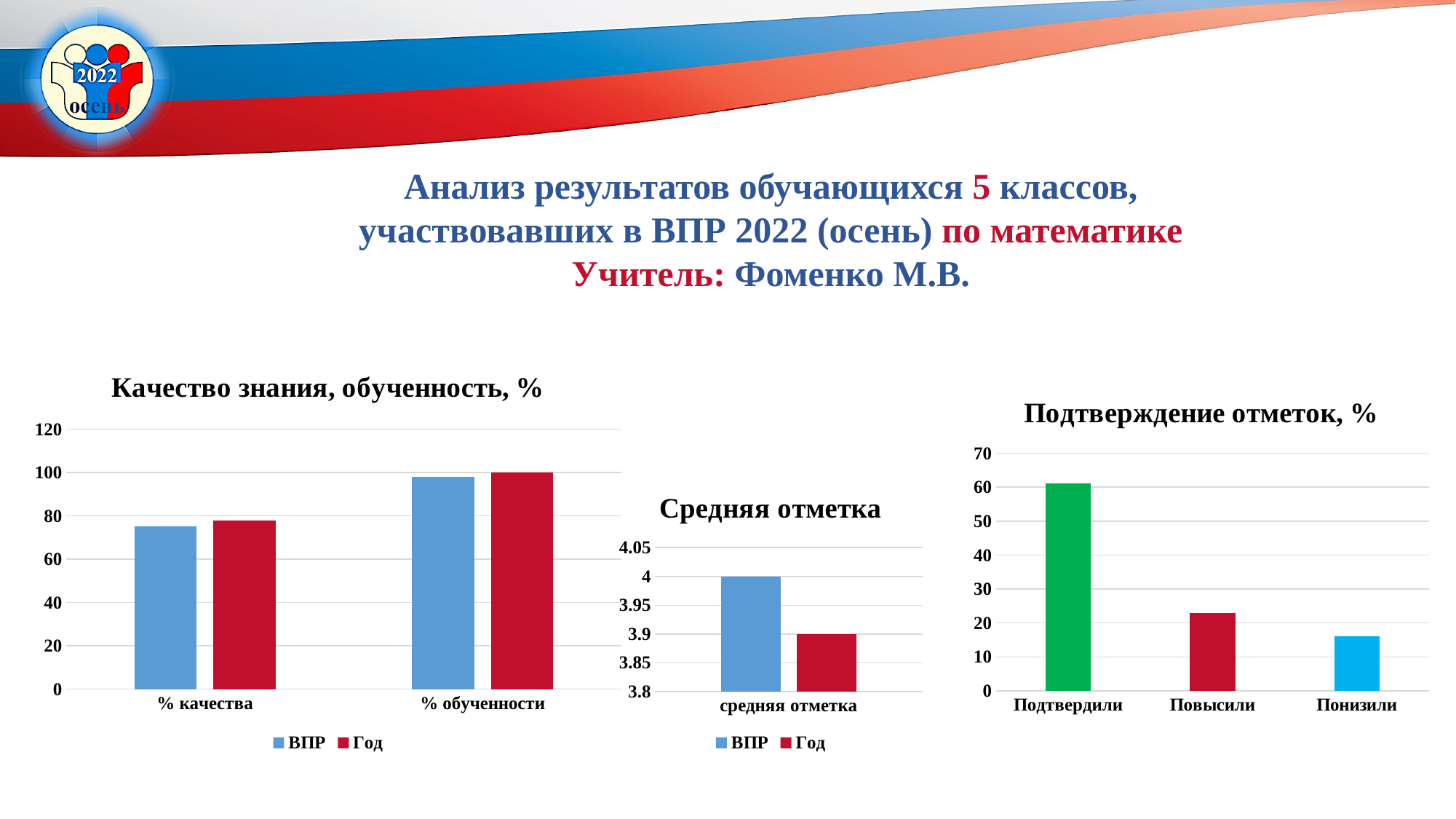
What type of chart is the 'Подтверждение отметок, %' chart? Bar chart In the 'Качество знания, обученность, %' chart, is the ВПР value for % качества greater or less than 60? greater In the 'Подтверждение отметок, %' chart, which category has the lowest value? Понизили In the 'Средняя отметка' chart, what is the value for Год? 3.9 How many series does the legend of the 'Качество знания, обученность, %' chart list? 2 In the 'Средняя отметка' chart, which series has the higher value, ВПР or Год? ВПР In the 'Подтверждение отметок, %' chart, which category has the highest value? Подтвердили In the 'Качество знания, обученность, %' chart, which category has the higher values, % качества or % обученности? % обученности In the 'Средняя отметка' chart, what is the value for ВПР? 4 In the 'Подтверждение отметок, %' chart, is the value for Повысили greater or less than 30? less In the 'Подтверждение отметок, %' chart, is the value for Подтвердили greater or less than 50? greater How many categories are shown in the 'Подтверждение отметок, %' chart? 3